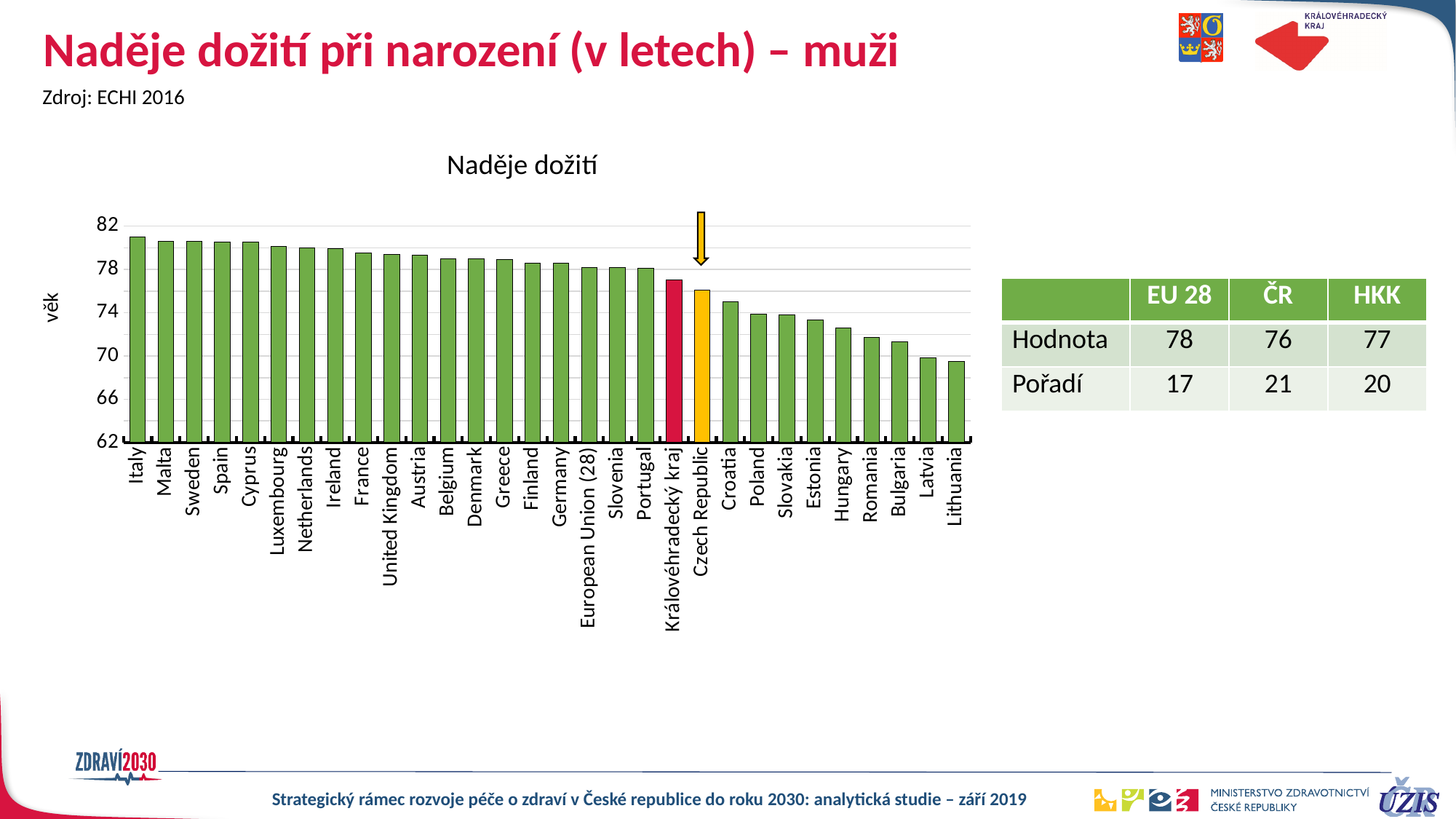
Is the value for Romania greater or less than 70? greater What is the label on the vertical axis of the chart? věk Which has the higher bar, Královéhradecký kraj or Czech Republic? Královéhradecký kraj What kind of chart is shown on the slide? bar chart Do the bar values rise or fall from left to right along the x axis? fall Is the value for Czech Republic greater or less than 78? less What is the title of the chart? Naděje dožití Which category has the highest bar in the chart? Italy Is the value for Hungary greater or less than 74? less How many countries or regions are shown as bars in the chart? 30 According to the table next to the chart, what is the value (Hodnota) for ČR? 76